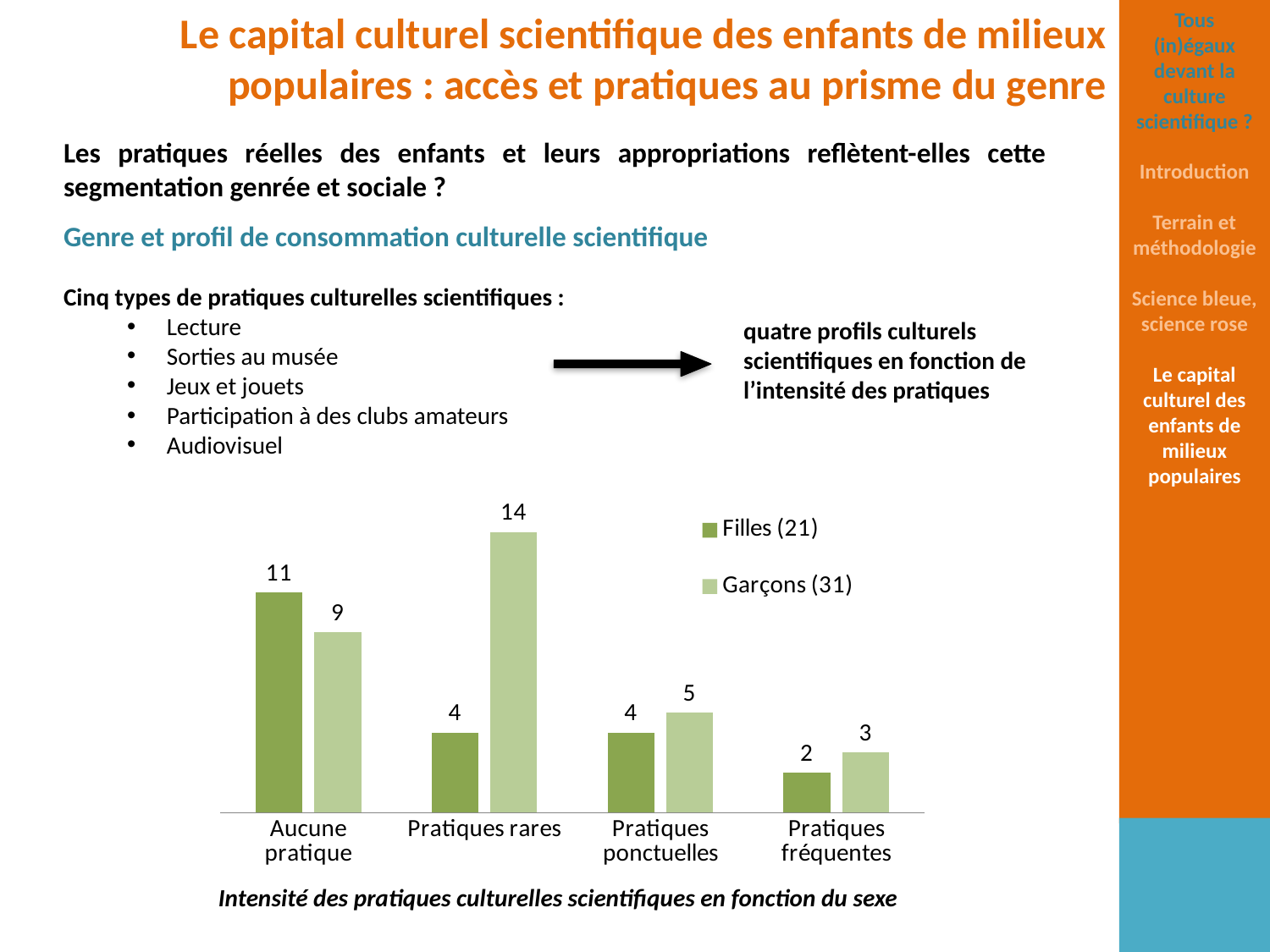
What is the difference between Garçons (31) and Filles (21) in the Pratiques rares category? 10 What is the value for Garçons (31) in the Pratiques rares category? 14 What is the value for Garçons (31) in the Pratiques fréquentes category? 3 In the Aucune pratique category, which series has the larger value, Filles (21) or Garçons (31)? Filles (21) What is the difference between Filles (21) and Garçons (31) in the Pratiques ponctuelles category? 1 Which category has the highest value for Garçons (31)? Pratiques rares How many categories are shown on the x axis of the chart? 4 What is the caption below the chart? Intensité des pratiques culturelles scientifiques en fonction du sexe Which category has the lowest value for Filles (21)? Pratiques fréquentes What kind of chart is shown on the slide? Bar chart What is the value for Filles (21) in the Aucune pratique category? 11 How many series does the legend list? 2